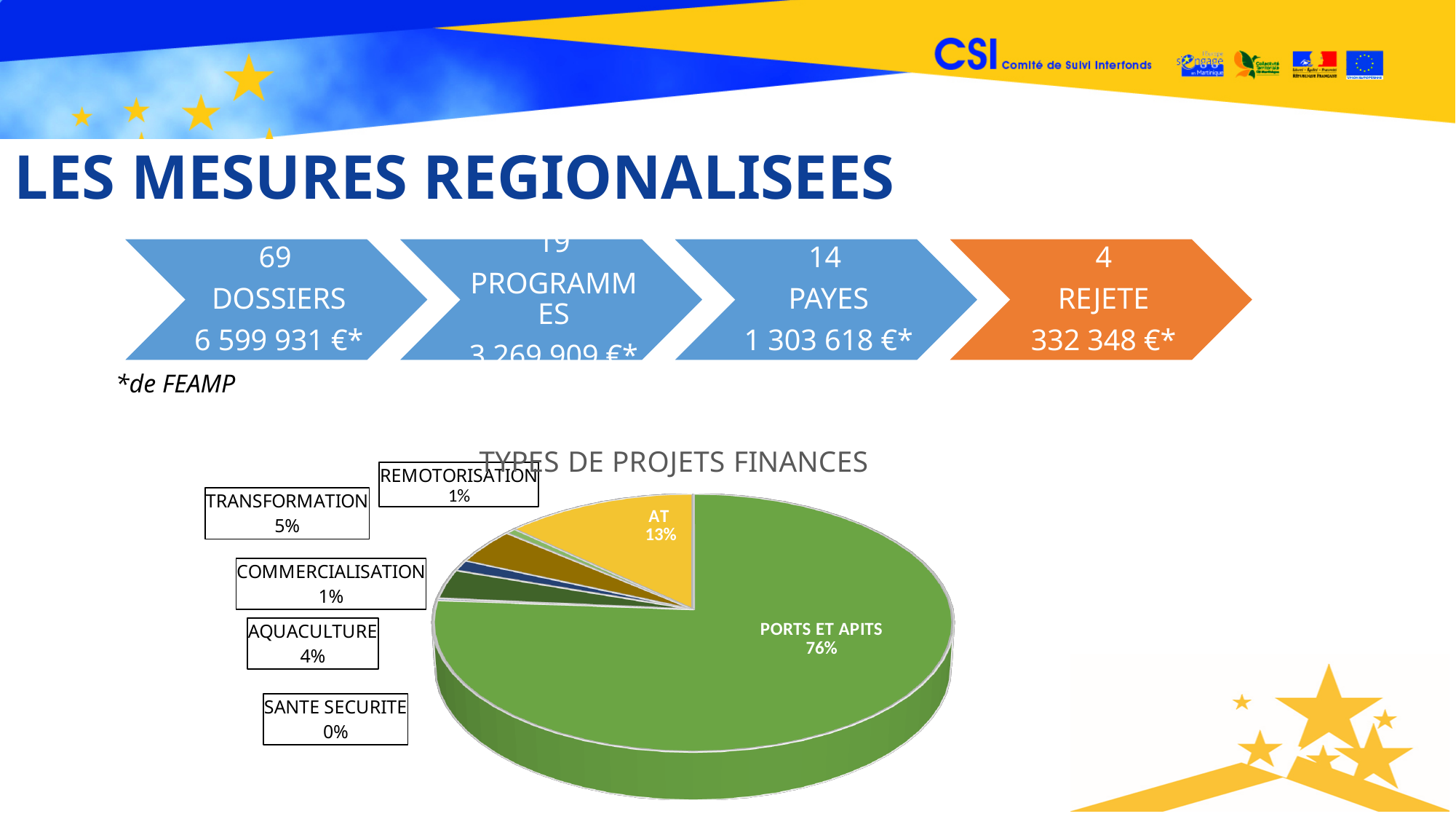
How many categories are labelled in the pie chart? 7 What percentage is shown for AT in the pie chart? 13% Which category has the largest slice of the pie chart? PORTS ET APITS What type of chart is shown under the title TYPES DE PROJETS FINANCES? pie chart Which has a larger share, TRANSFORMATION or AQUACULTURE? TRANSFORMATION What percentage is shown for TRANSFORMATION in the pie chart? 5% What percentage is shown for AQUACULTURE in the pie chart? 4% What share of the pie does PORTS ET APITS represent? 76% What percentage is shown for SANTE SECURITE in the pie chart? 0% What is the title of the pie chart? TYPES DE PROJETS FINANCES What is the difference in percentage points between PORTS ET APITS and AT? 63% Which category has the smallest share in the pie chart? SANTE SECURITE